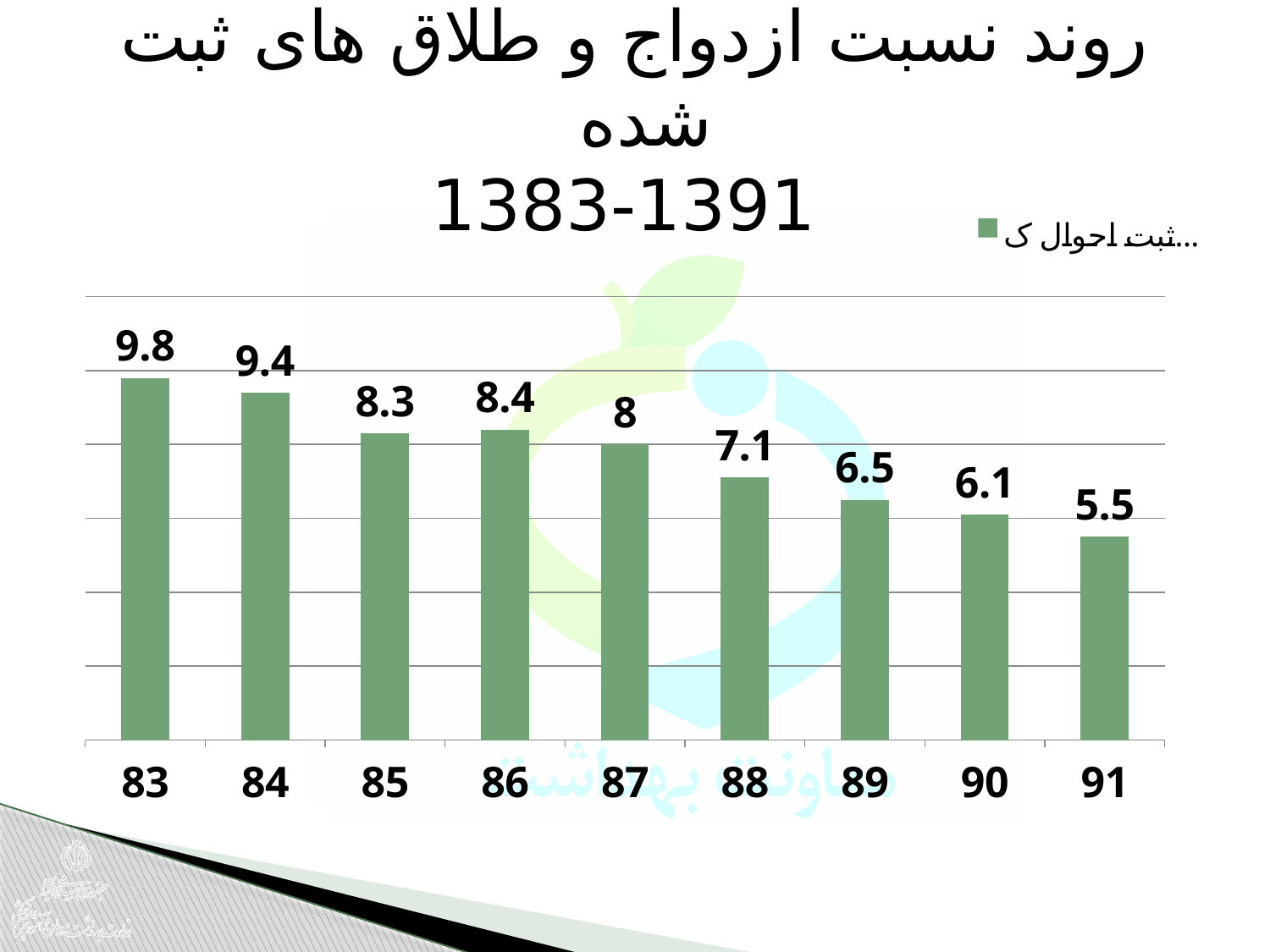
How many series does the legend list? 1 Do the values generally rise or fall from 83 to 91? fall Which is larger, the value for 88 or the value for 89? 88 Which category has the lowest value? 91 What kind of chart is shown on the slide? bar chart What is the value for 87? 8 What is the value for 91? 5.5 What is the value for 83? 9.8 What is the difference between the values for 86 and 85? 0.1 What is the difference between the values for 83 and 91? 4.3 Which category has the highest value? 83 How many categories are shown on the x axis? 9